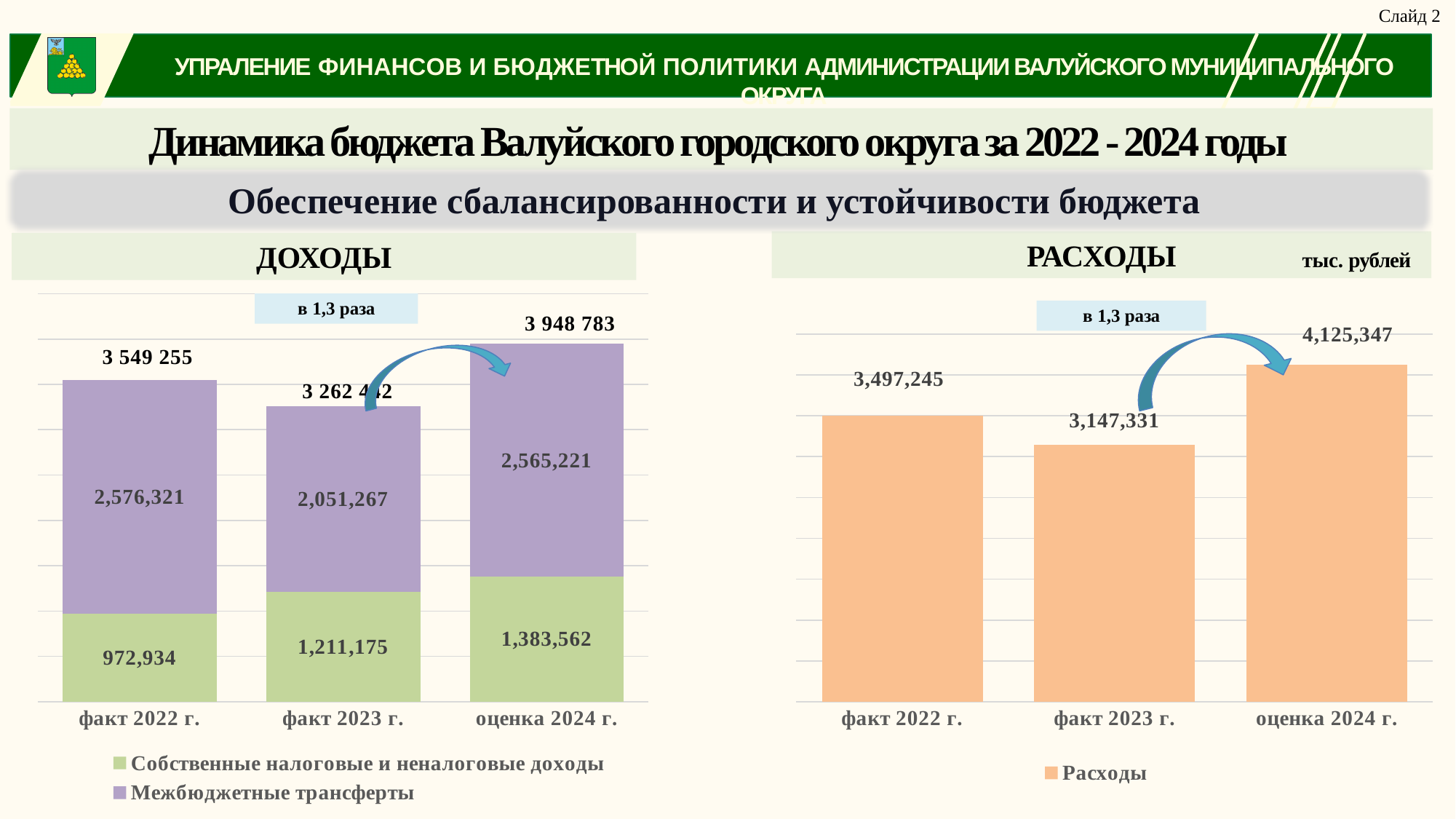
On the РАСХОДЫ chart, which year has the highest value? оценка 2024 г. On the ДОХОДЫ chart, which year has the lowest value of Межбюджетные трансферты? факт 2023 г. On the ДОХОДЫ chart, what is the value of Собственные налоговые и неналоговые доходы for факт 2022 г.? 972,934 On the РАСХОДЫ chart, how many categories are shown on the x axis? 3 On the РАСХОДЫ chart, what is the difference between оценка 2024 г. and факт 2023 г.? 978,016 What kind of chart is the РАСХОДЫ chart? bar chart On the РАСХОДЫ chart, which is larger: факт 2022 г. or факт 2023 г.? факт 2022 г. On the ДОХОДЫ chart, what is the difference between Собственные налоговые и неналоговые доходы for оценка 2024 г. and факт 2022 г.? 410,628 On the РАСХОДЫ chart, what is the value for факт 2023 г.? 3,147,331 On the ДОХОДЫ chart, what is the value of Межбюджетные трансферты for оценка 2024 г.? 2,565,221 On the ДОХОДЫ chart, what is the total of the stacked bar for факт 2022 г.? 3 549 255 On the ДОХОДЫ chart, how many series does the legend list? 2